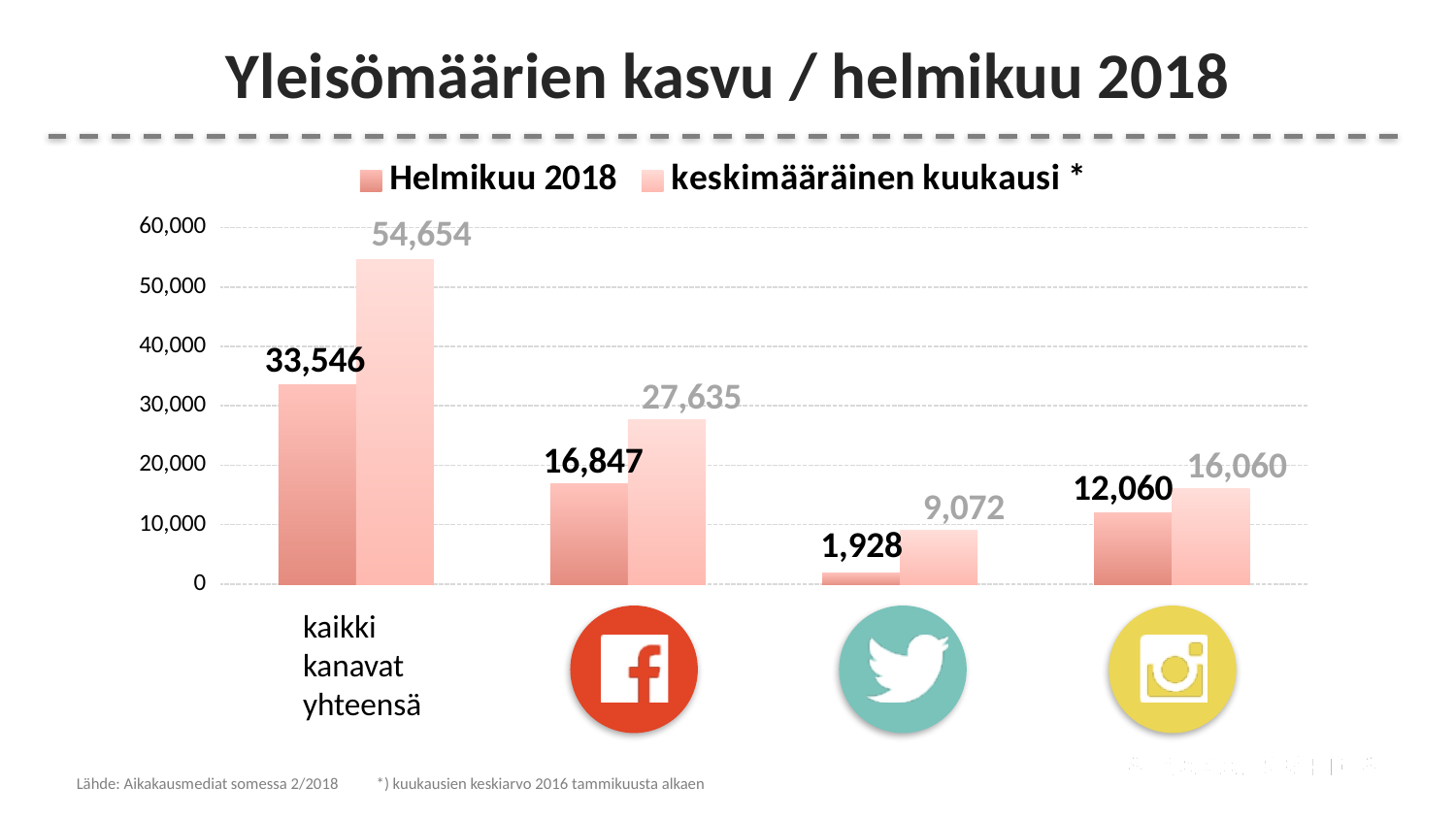
For the category marked with the Facebook icon, which is larger: the Helmikuu 2018 value or the 'keskimääräinen kuukausi *' value? keskimääräinen kuukausi * Which category has the highest 'keskimääräinen kuukausi *' value? kaikki kanavat yhteensä How many series does the legend list? 2 What kind of chart is shown on the slide? bar chart What is the 'keskimääräinen kuukausi *' value for the category marked with the Twitter icon (third category)? 9,072 What is the value for 'keskimääräinen kuukausi *' in the category 'kaikki kanavat yhteensä'? 54,654 Which category has the lowest Helmikuu 2018 value? Twitter (third category) What is the difference between the 'keskimääräinen kuukausi *' value and the Helmikuu 2018 value for the category marked with the Instagram icon (fourth category)? 4,000 What is the value for Helmikuu 2018 in the category 'kaikki kanavat yhteensä'? 33,546 What is the Helmikuu 2018 value for the category marked with the Facebook icon (second category)? 16,847 How many categories are shown on the x axis of the chart? 4 What is the difference between the 'keskimääräinen kuukausi *' value and the Helmikuu 2018 value for 'kaikki kanavat yhteensä'? 21,108